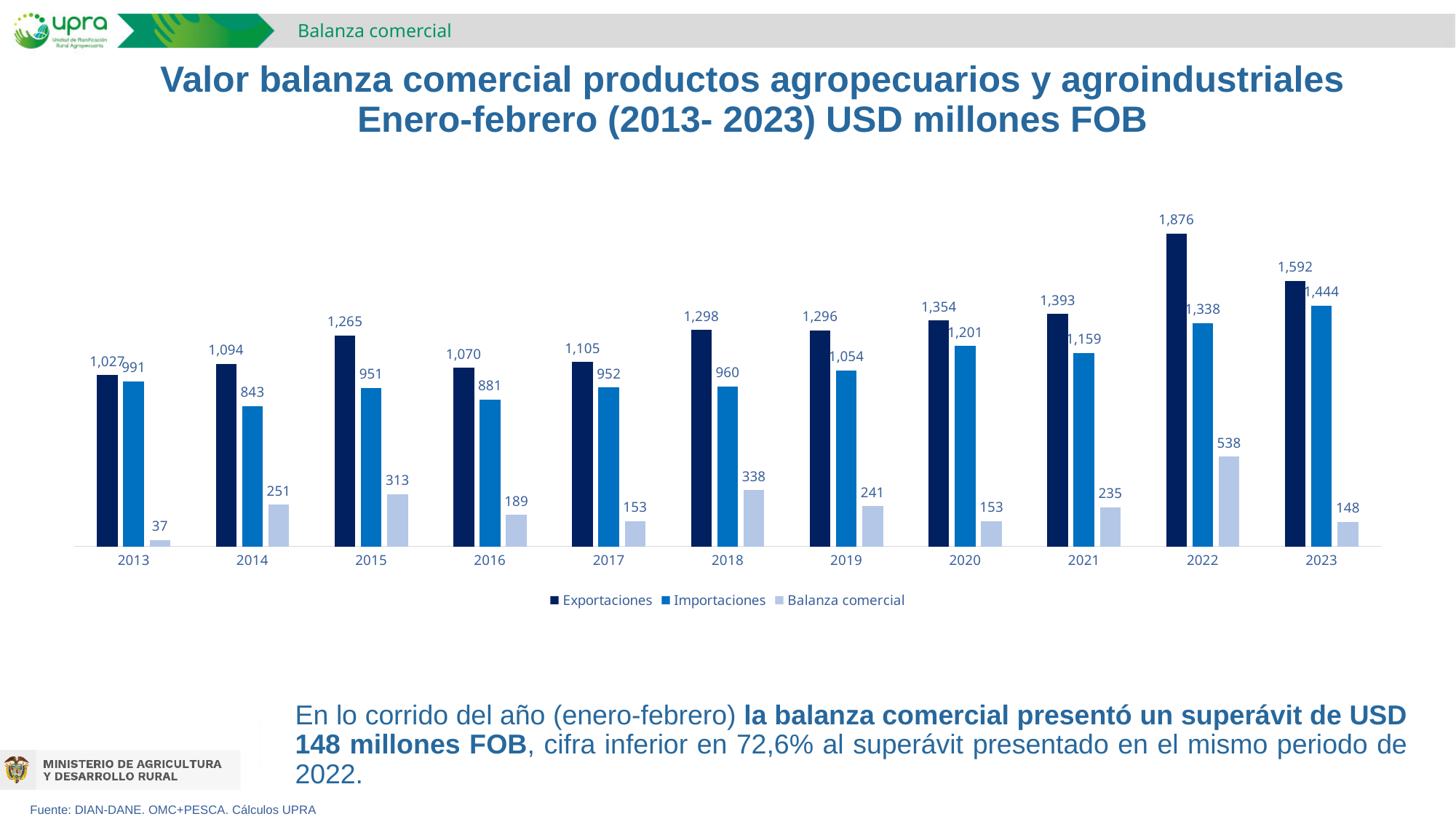
What is the difference between Exportaciones and Importaciones in 2023? 148 Which year has the highest Exportaciones value? 2022 Which is larger in 2015: Exportaciones or Importaciones? Exportaciones How many series does the legend list? 3 What is the value of Exportaciones in 2022? 1,876 What is the value of Balanza comercial in 2023? 148 Which year has the lowest Balanza comercial value? 2013 What is the value of Importaciones in 2019? 1,054 What kind of chart is shown on the slide? Bar chart Which series is shown in the darkest blue colour? Exportaciones How many years are shown on the x axis? 11 Did the Balanza comercial value rise or fall from 2022 to 2023? Fall